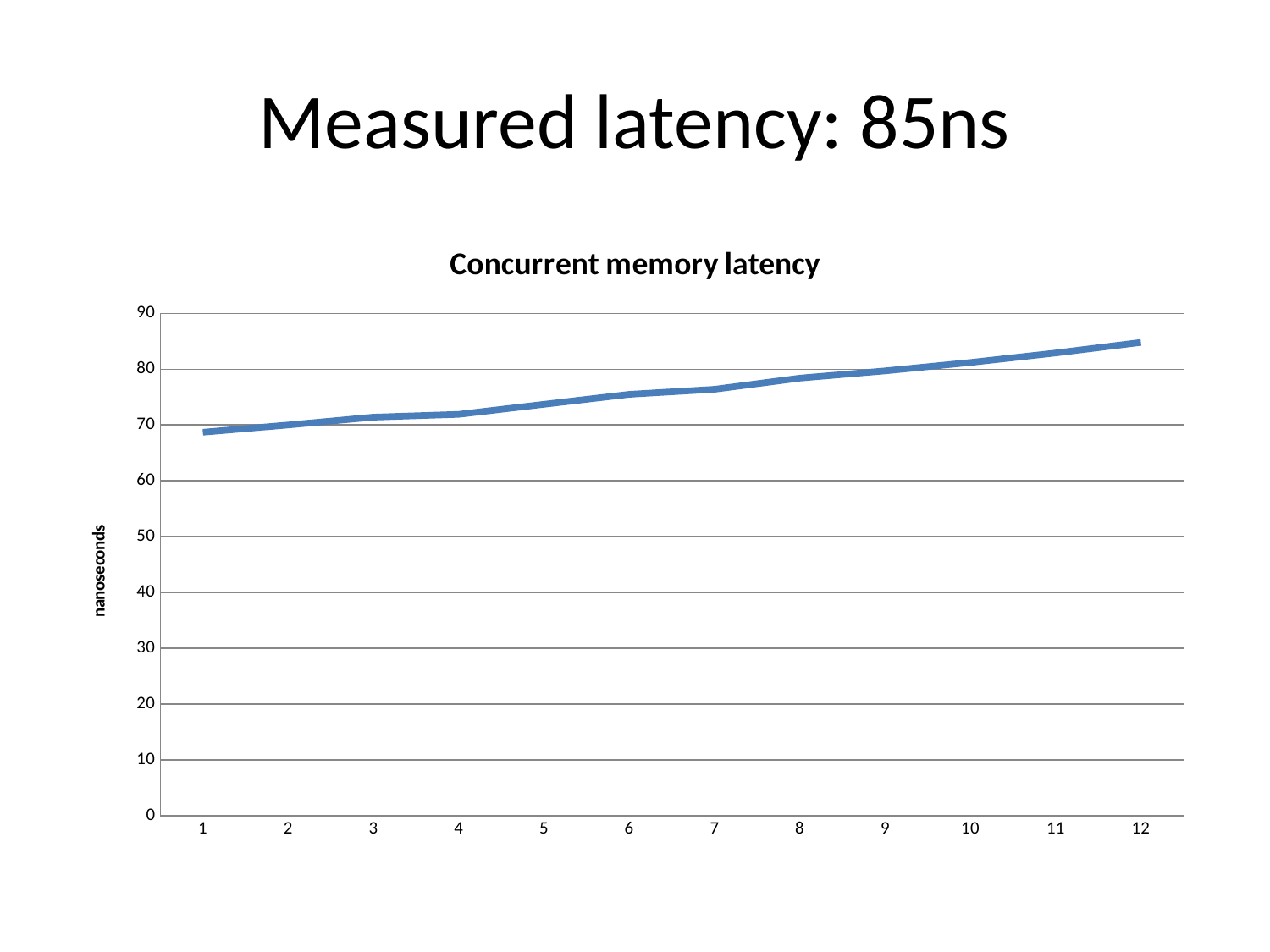
Is the value at x = 6 greater or less than 70? greater At which x-axis value is the latency highest? 12 Do the values rise or fall as the x axis goes from 1 to 12? rise Is the value at x = 1 greater or less than 70? less What is the label on the vertical axis of the chart? nanoseconds At which x-axis value is the latency lowest? 1 What kind of chart is shown on the slide? line chart What is the title of the chart? Concurrent memory latency How many points are plotted along the x axis of the chart? 12 Which has the larger value, x = 3 or x = 10? 10 Is the value at x = 12 greater or less than 80? greater